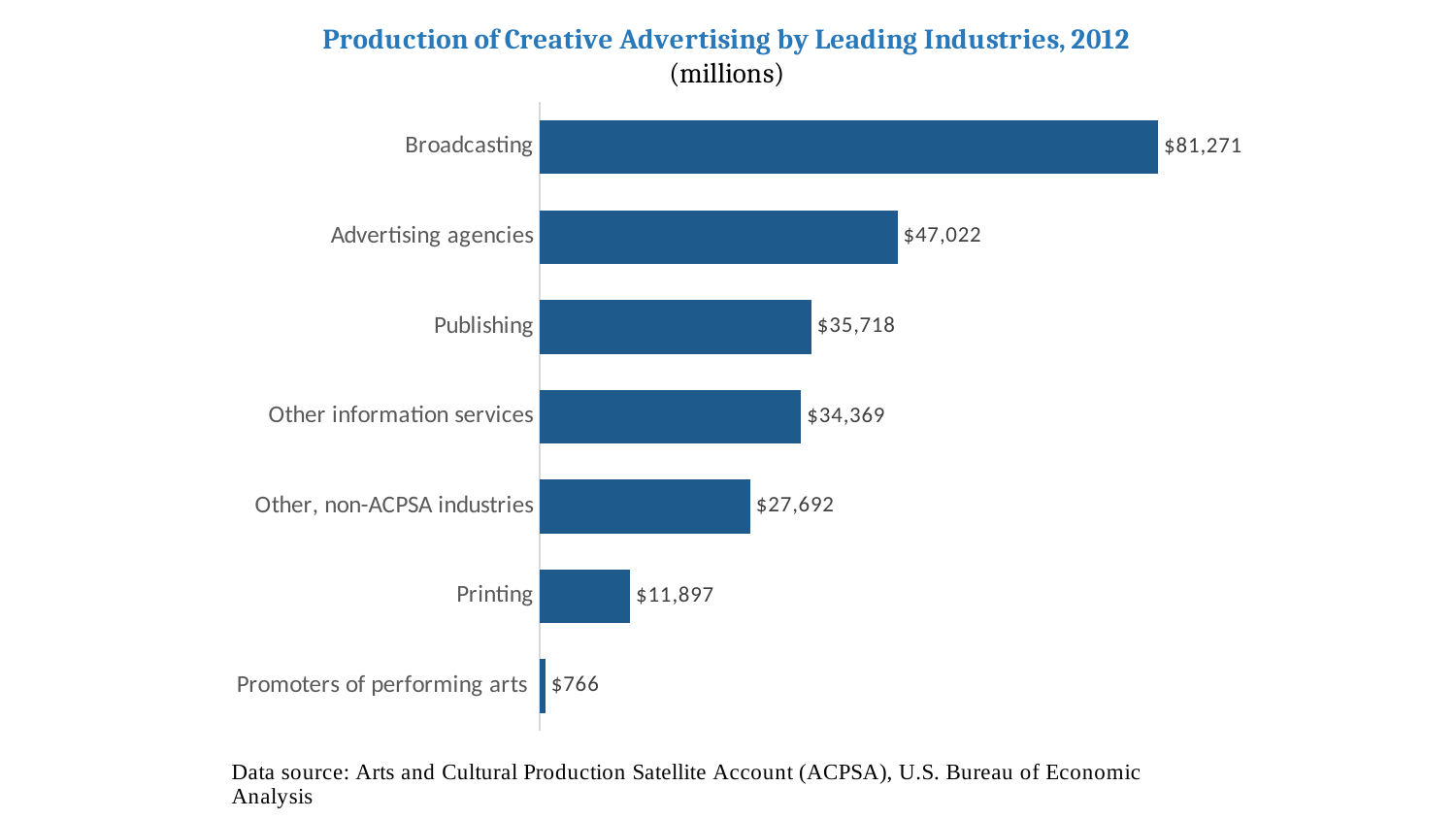
What is the difference between the values for Broadcasting and Advertising agencies? $34,249 What is the value for Broadcasting? $81,271 Which industry has the lowest value? Promoters of performing arts What is the value for Publishing? $35,718 What is the difference between the values for Publishing and Other information services? $1,349 Which is larger, the value for Advertising agencies or the value for Publishing? Advertising agencies What is the value for Printing? $11,897 What is the title of the chart? Production of Creative Advertising by Leading Industries, 2012 Which industry has the highest value? Broadcasting How many industries are shown in the chart? 7 What is the value for Other, non-ACPSA industries? $27,692 What kind of chart is this? Bar chart